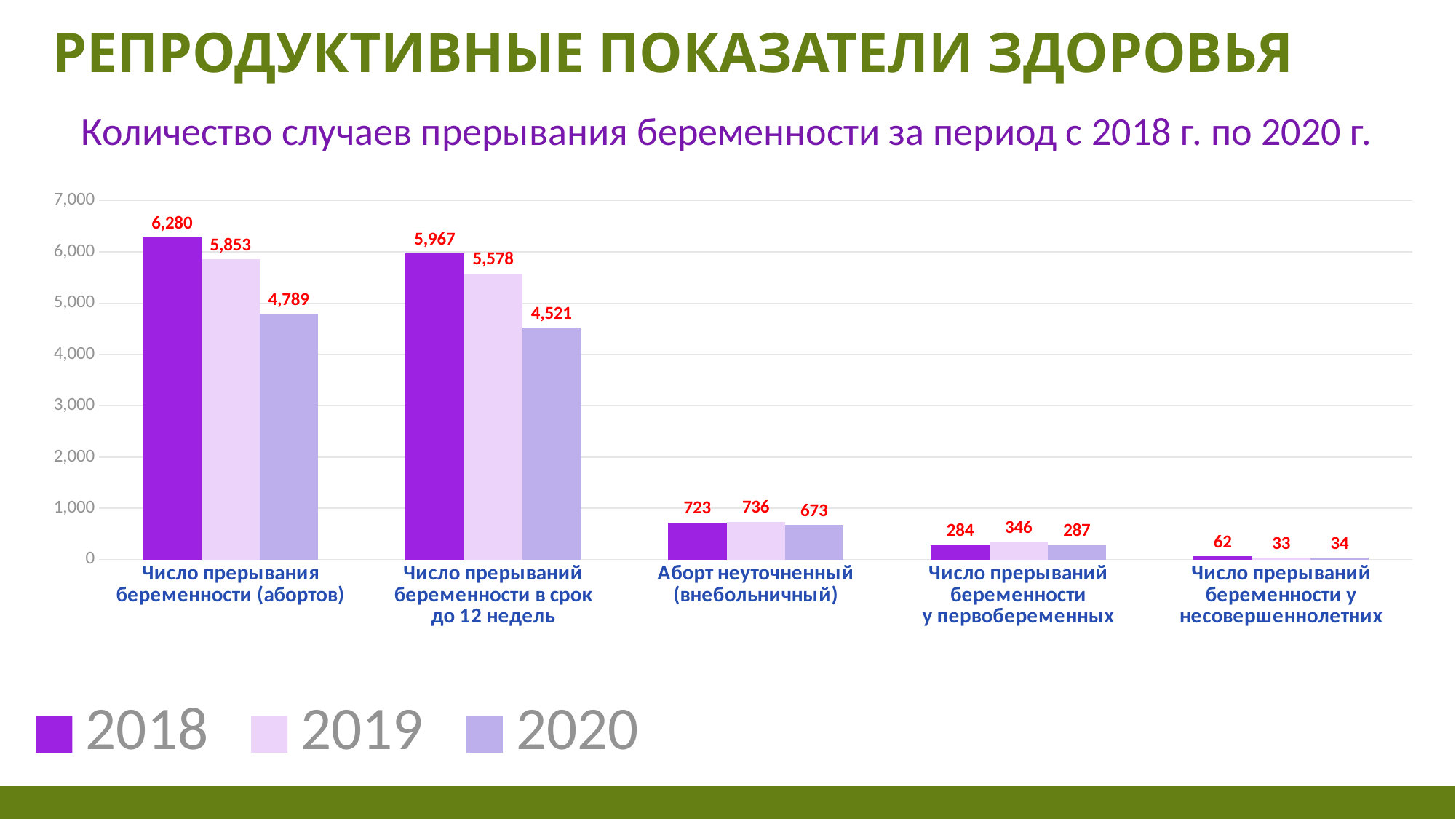
What is the value for 2018 in the category "Число прерывания беременности (абортов)"? 6,280 Which is larger in the category "Аборт неуточненный (внебольничный)": the 2018 value or the 2020 value? 2018 What is the value for 2019 in the category "Аборт неуточненный (внебольничный)"? 736 What is the value for 2019 in the category "Число прерываний беременности у несовершеннолетних"? 33 Which category has the lowest values across all three years? Число прерываний беременности у несовершеннолетних Which year has the highest value in the category "Число прерываний беременности у первобеременных"? 2019 What is the value for 2020 in the category "Число прерываний беременности в срок до 12 недель"? 4,521 How many categories are shown on the x axis? 5 Do the values for 2018 rise or fall from left to right across the categories? Fall What is the difference between the 2018 and 2020 values in the category "Число прерывания беременности (абортов)"? 1,491 What kind of chart is shown on the slide? Bar chart How many series does the legend list? 3